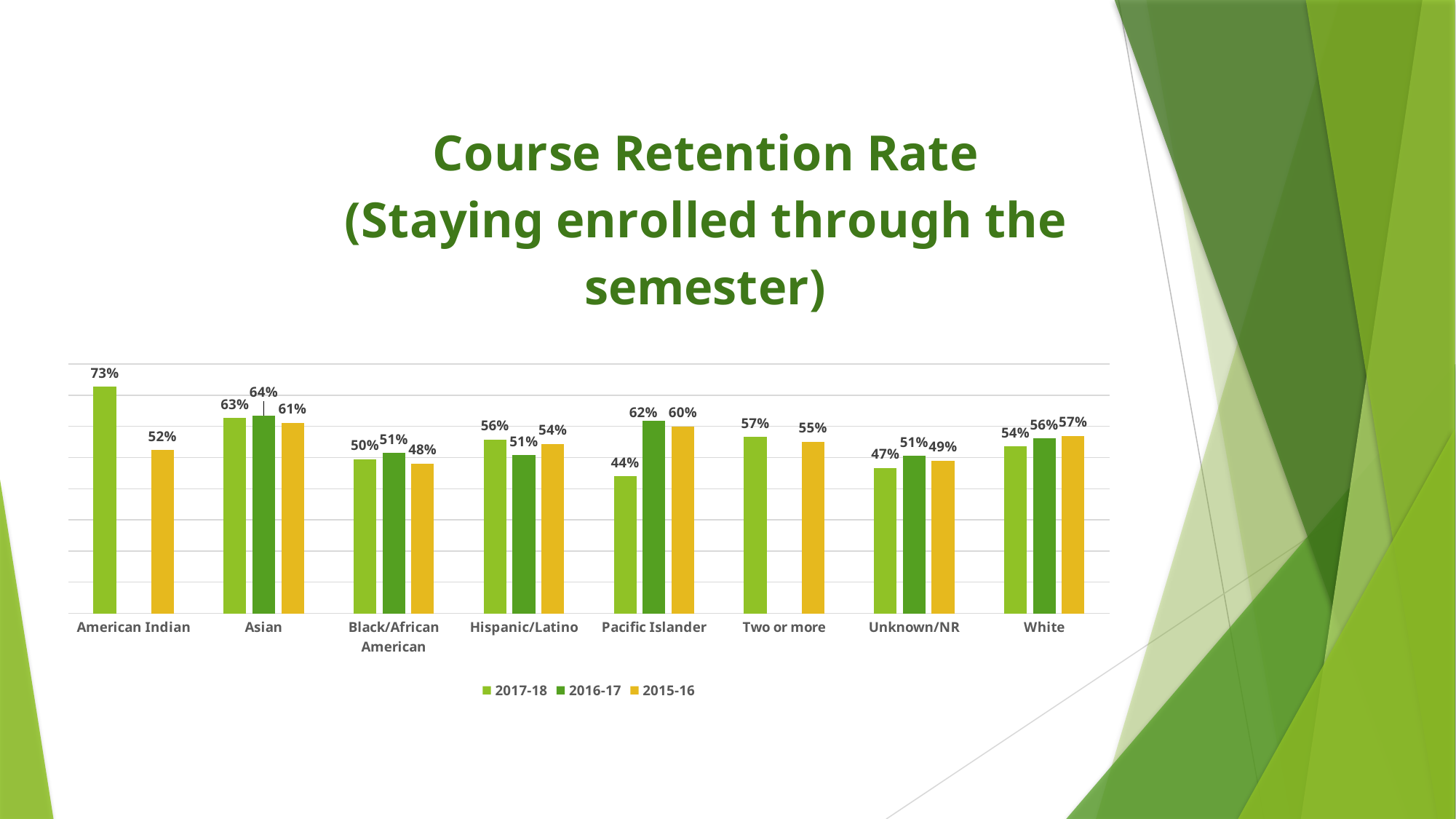
What kind of chart is shown on the slide? Bar chart How many categories are shown on the x axis of the chart? 8 Which series is shown in yellow/gold in the legend? 2015-16 What is the difference between the 2016-17 and 2017-18 retention rates for Pacific Islander students? 18% How many series does the legend list? 3 What is the 2015-16 course retention rate for White students? 57% What is the 2017-18 course retention rate for American Indian students? 73% Do the retention rates for Asian students rise or fall from 2015-16 to 2017-18 (61%, 64%, 63%)? Rise then fall Which category has the highest 2017-18 course retention rate? American Indian Which category has the lowest 2017-18 course retention rate? Pacific Islander Which is larger for Hispanic/Latino students: the 2017-18 rate or the 2016-17 rate? 2017-18 What is the 2016-17 course retention rate for Pacific Islander students? 62%